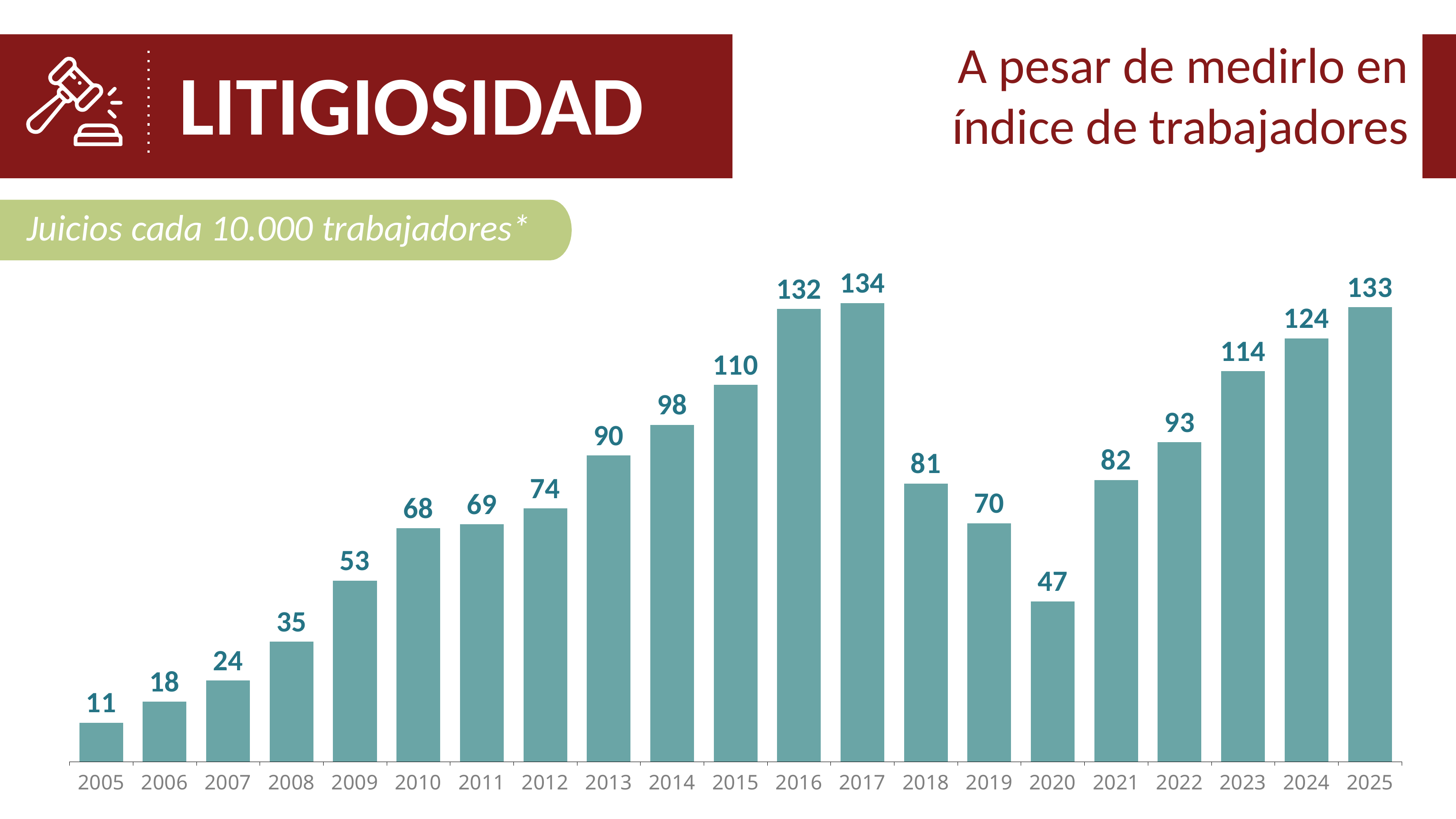
What is the value for 2020? 47 Do the values rise or fall from 2005 to 2017? rise Which is larger, the value for 2016 or the value for 2025? 2025 What is the value for 2005? 11 What kind of chart is this? bar chart What is the difference between the values for 2025 and 2024? 9 What is the subtitle label above the chart? Juicios cada 10.000 trabajadores* Which year has the highest value? 2017 How many years are shown on the x axis? 21 Which year has the lowest value? 2005 What is the value for 2017? 134 What is the difference between the values for 2017 and 2018? 53